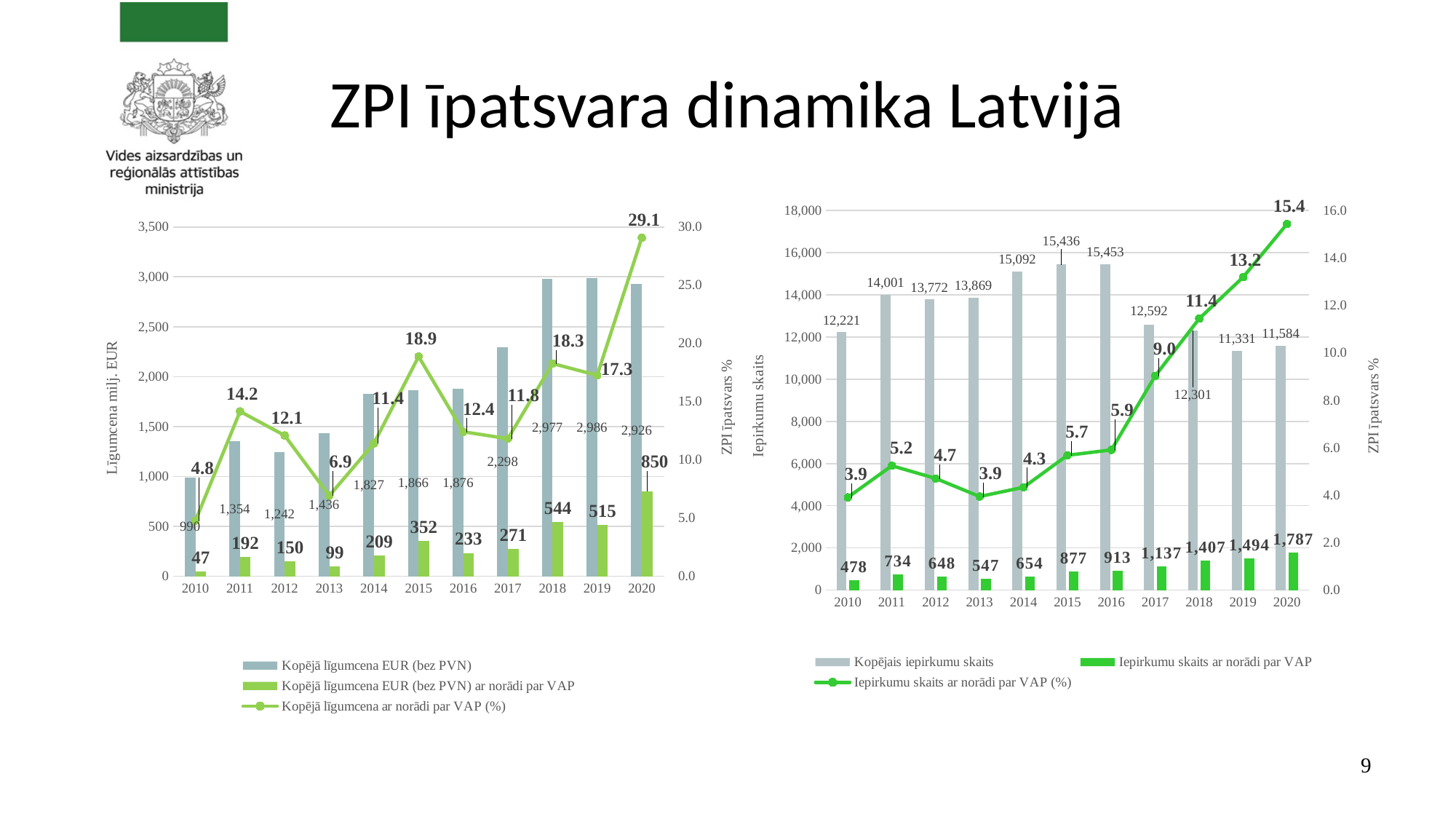
In the left chart, what is the difference between the 'Kopējā līgumcena EUR (bez PVN) ar norādi par VAP' values for 2020 and 2019? 335 In the right chart, does 'Iepirkumu skaits ar norādi par VAP (%)' rise or fall from 2016 to 2020? rise In the left chart, what is the value of 'Kopējā līgumcena EUR (bez PVN) ar norādi par VAP' for 2020? 850 In the right chart, which year has the lowest value of 'Iepirkumu skaits ar norādi par VAP'? 2010 In the right chart, what is the value of 'Kopējais iepirkumu skaits' for 2016? 15,453 In the left chart, which year has the highest value of 'Kopējā līgumcena EUR (bez PVN)'? 2019 In the left chart, what is the value of 'Kopējā līgumcena EUR (bez PVN)' for 2017? 2,298 In the right chart, what is the value of 'Iepirkumu skaits ar norādi par VAP (%)' for 2018? 11.4 In the right chart, which is larger: 'Kopējais iepirkumu skaits' for 2010 or for 2019? 2010 In the left chart, what is the value of 'Kopējā līgumcena ar norādi par VAP (%)' for 2015? 18.9 How many years are shown on the x axis of the right chart? 11 How many series does the legend of the left chart list? 3